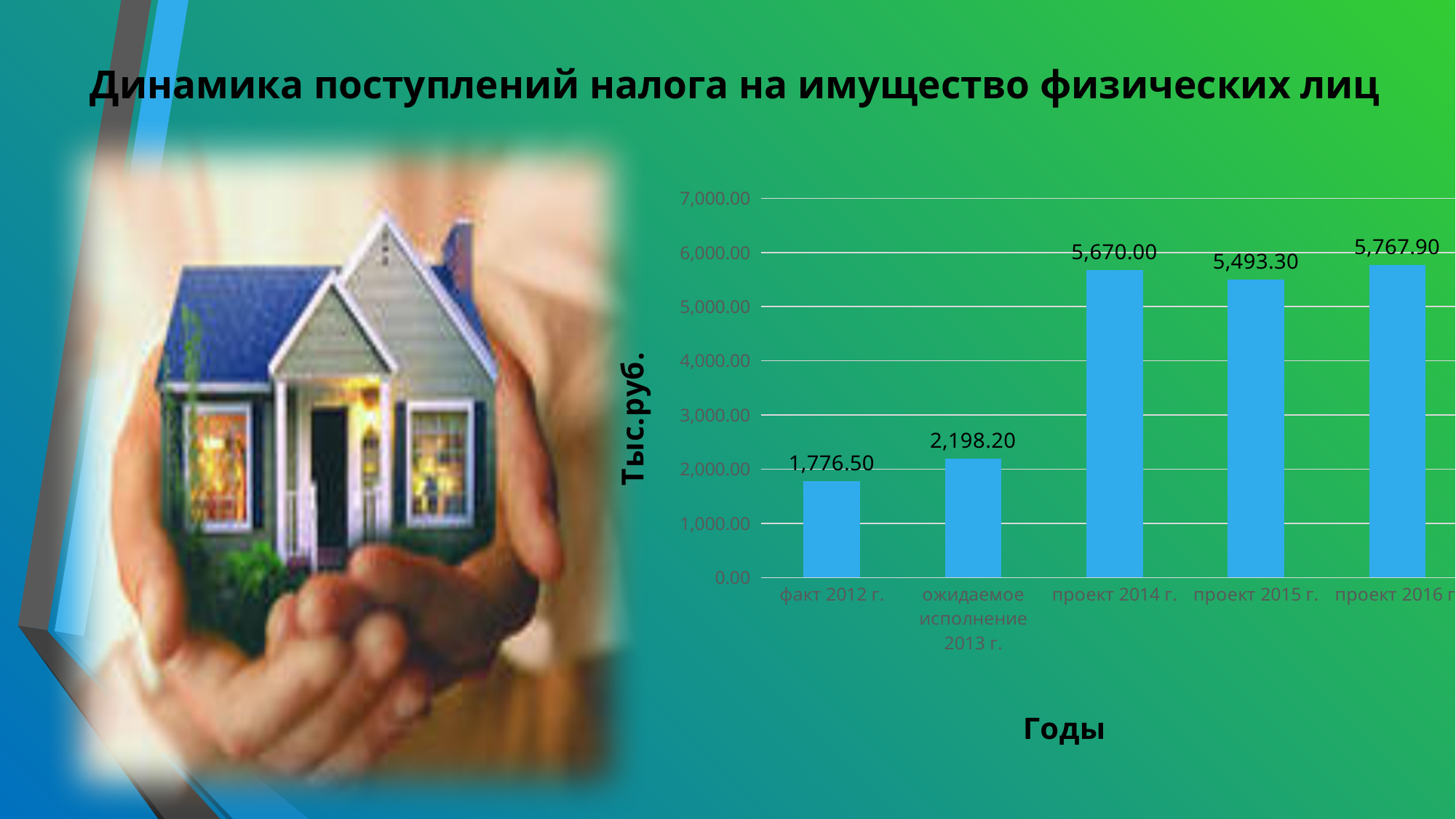
What is the value for проект 2015 г.? 5,493.30 What is the value for факт 2012 г.? 1,776.50 What is the label of the vertical axis? Тыс.руб. What is the value for ожидаемое исполнение 2013 г.? 2,198.20 What kind of chart is shown on the slide? bar chart What is the difference between the values for ожидаемое исполнение 2013 г. and факт 2012 г.? 421.70 Which category has the highest value? проект 2016 г. Which is larger, the value for проект 2014 г. or the value for проект 2015 г.? проект 2014 г. Is the value for проект 2016 г. greater or less than 5,000.00? greater How many categories are shown on the x axis? 5 Which category has the lowest value? факт 2012 г. What is the difference between the values for проект 2014 г. and проект 2015 г.? 176.70